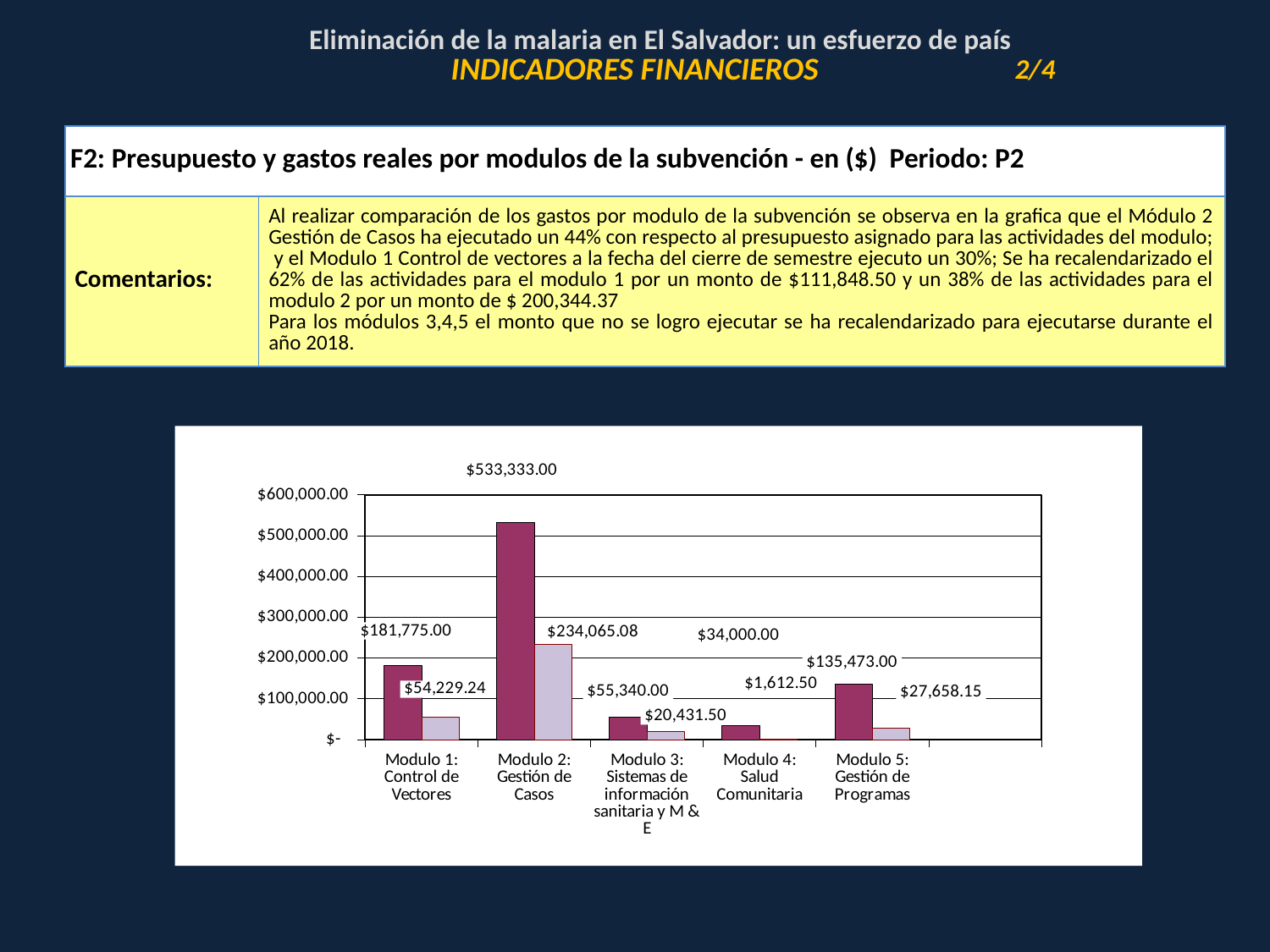
What is the value of the light lavender bar for Modulo 4: Salud Comunitaria? $1,612.50 Is the dark purple bar for Modulo 2: Gestión de Casos greater or less than $500,000.00? greater What is the value of the dark purple bar for Modulo 5: Gestión de Programas? $135,473.00 Which is larger: the dark purple bar for Modulo 1: Control de Vectores or the dark purple bar for Modulo 5: Gestión de Programas? Modulo 1: Control de Vectores How many modules (categories) are shown on the x axis of the chart? 5 What is the title of the section above the chart on the slide? F2: Presupuesto y gastos reales por modulos de la subvención - en ($) Periodo: P2 What is the difference between the dark purple bar and the light lavender bar for Modulo 3: Sistemas de información sanitaria y M & E? $34,908.50 Which module has the lowest light lavender bar? Modulo 4: Salud Comunitaria What type of chart is shown on the slide? bar chart What is the value of the dark purple bar for Modulo 2: Gestión de Casos? $533,333.00 Which module has the highest dark purple bar? Modulo 2: Gestión de Casos What is the value of the light lavender bar for Modulo 1: Control de Vectores? $54,229.24